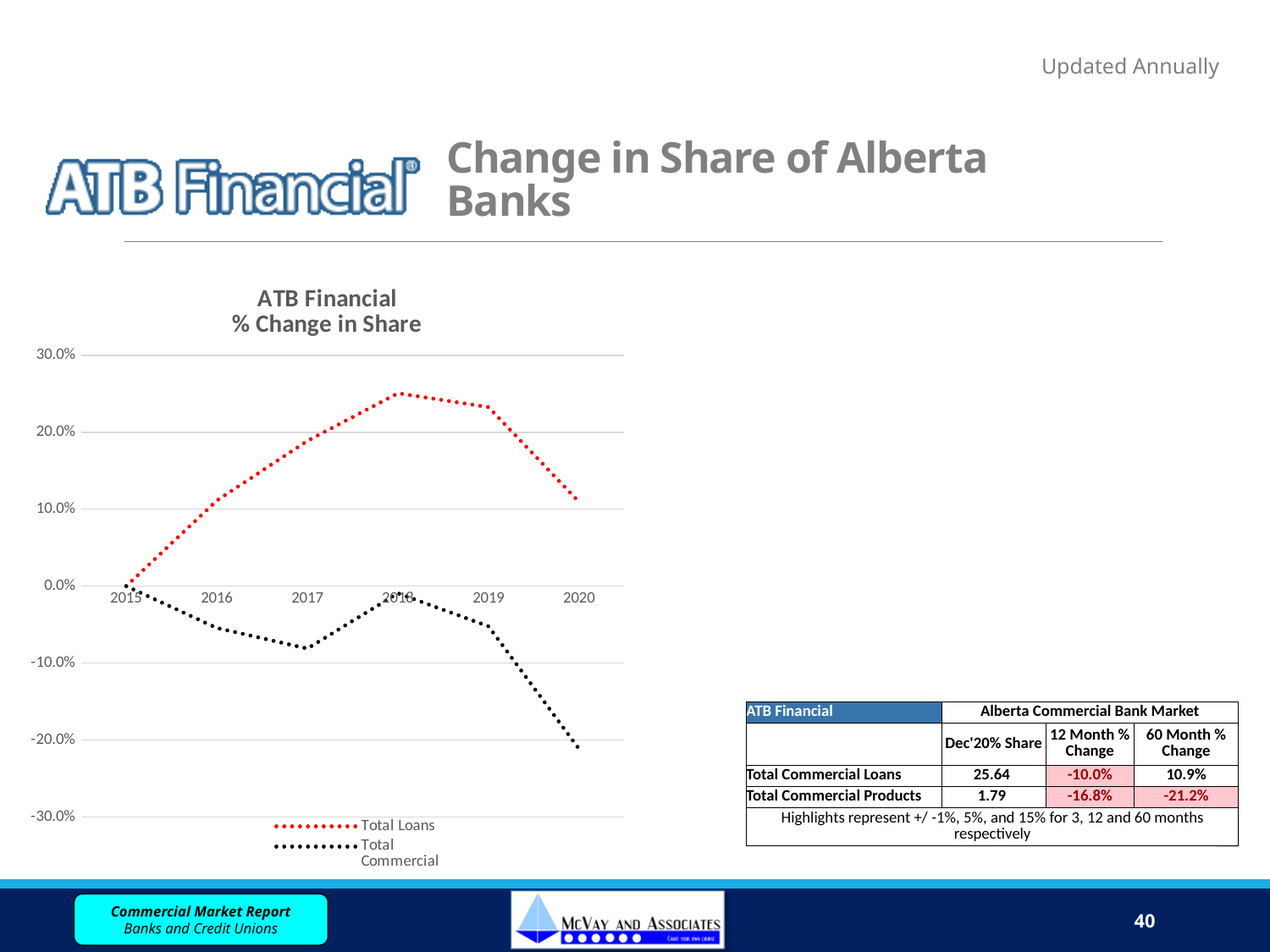
What kind of chart is shown on the slide? line chart Is the value for Total Commercial in 2020 greater or less than -20.0%? less Does the Total Commercial series rise or fall from 2018 to 2020? fall Which series is drawn in red on the chart? Total Loans How many series does the chart legend list? 2 Is the value for Total Loans in 2020 greater or less than 10.0%? greater In which year does the Total Loans series reach its highest value? 2018 What is the title of the chart? ATB Financial % Change in Share In 2019, which series has the higher value, Total Loans or Total Commercial? Total Loans How many years are plotted along the x axis of the chart? 6 Is the value for Total Loans in 2018 greater or less than 20.0%? greater In which year does the Total Commercial series reach its lowest value? 2020